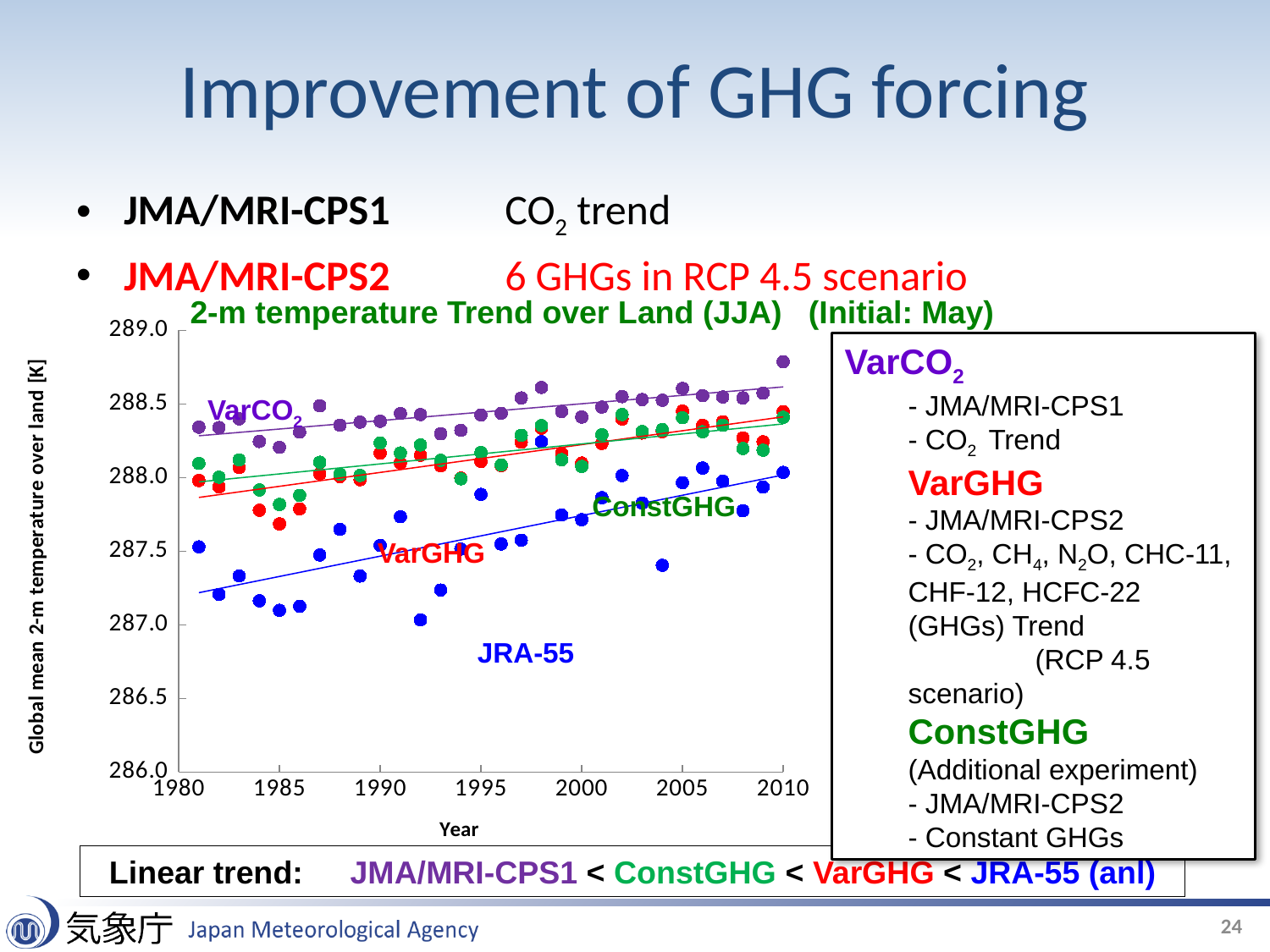
In 1981, which is larger: the VarCO2 value or the JRA-55 value? VarCO2 Is the VarCO2 value for 1981 greater or less than 288.0? greater How many data series are plotted on the chart? 4 Is the JRA-55 value for 1983 greater or less than 287.5? less Is the VarCO2 value for 2010 greater or less than 288.5? greater What is the title of the chart? 2-m temperature Trend over Land (JJA) (Initial: May) Which series has the highest values on the chart? VarCO2 What is the label of the x axis? Year What kind of chart is shown on the slide? scatter chart Which series has the lowest values on the chart? JRA-55 Do the JRA-55 values rise or fall from 1980 to 2010? rise